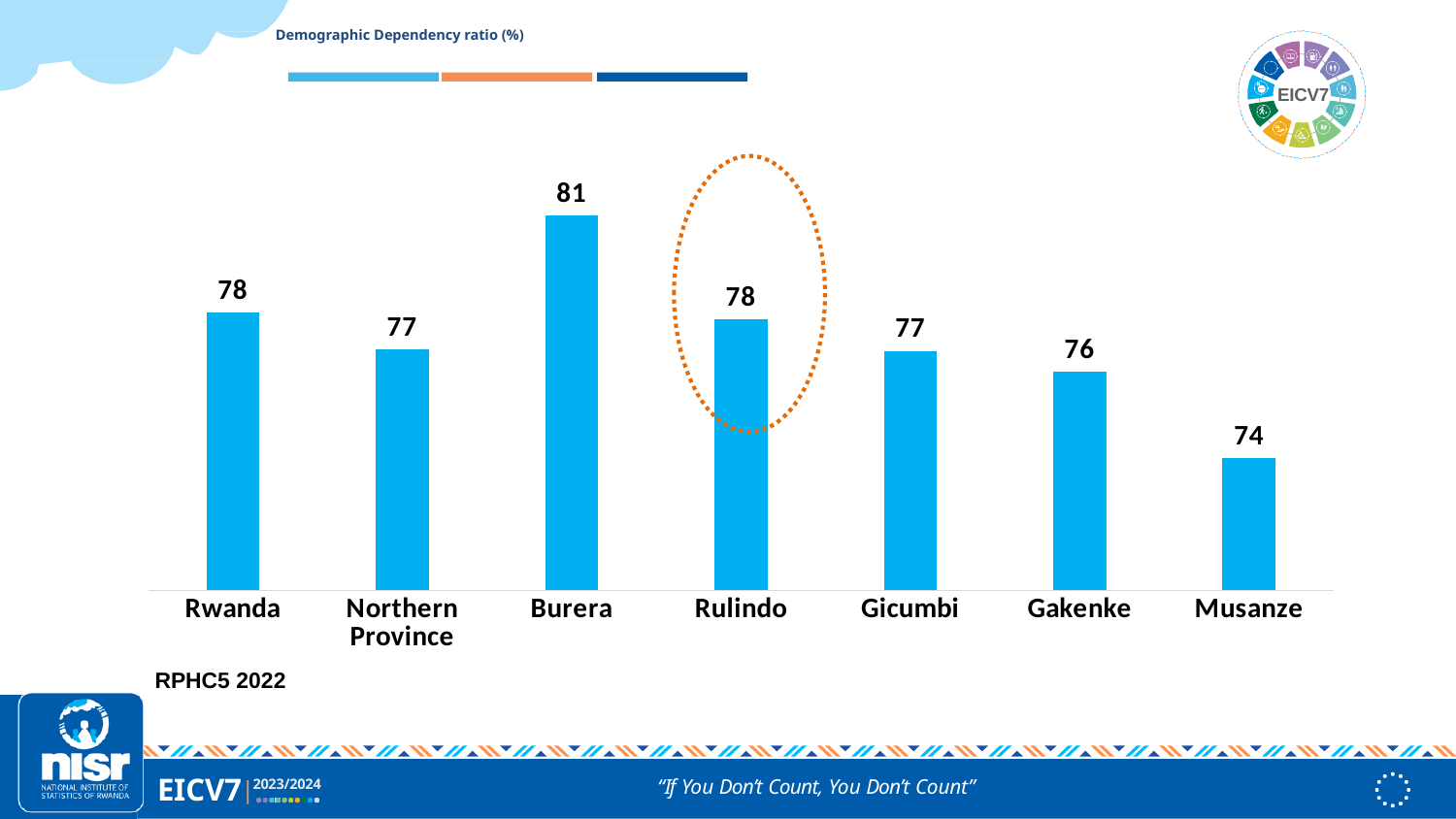
What is the demographic dependency ratio for Rulindo? 78 Which category's bar is highlighted with a dotted orange circle? Rulindo Which category has the lowest demographic dependency ratio? Musanze What is the difference between the demographic dependency ratio of Burera and Musanze? 7 What is the demographic dependency ratio for Burera? 81 How many categories are shown on the chart? 7 What is the demographic dependency ratio for Northern Province? 77 What is the demographic dependency ratio for Musanze? 74 Which has a higher demographic dependency ratio, Gakenke or Gicumbi? Gicumbi What kind of chart is shown on the slide? Bar chart What is the title of the chart? Demographic Dependency ratio (%) Which category has the highest demographic dependency ratio? Burera